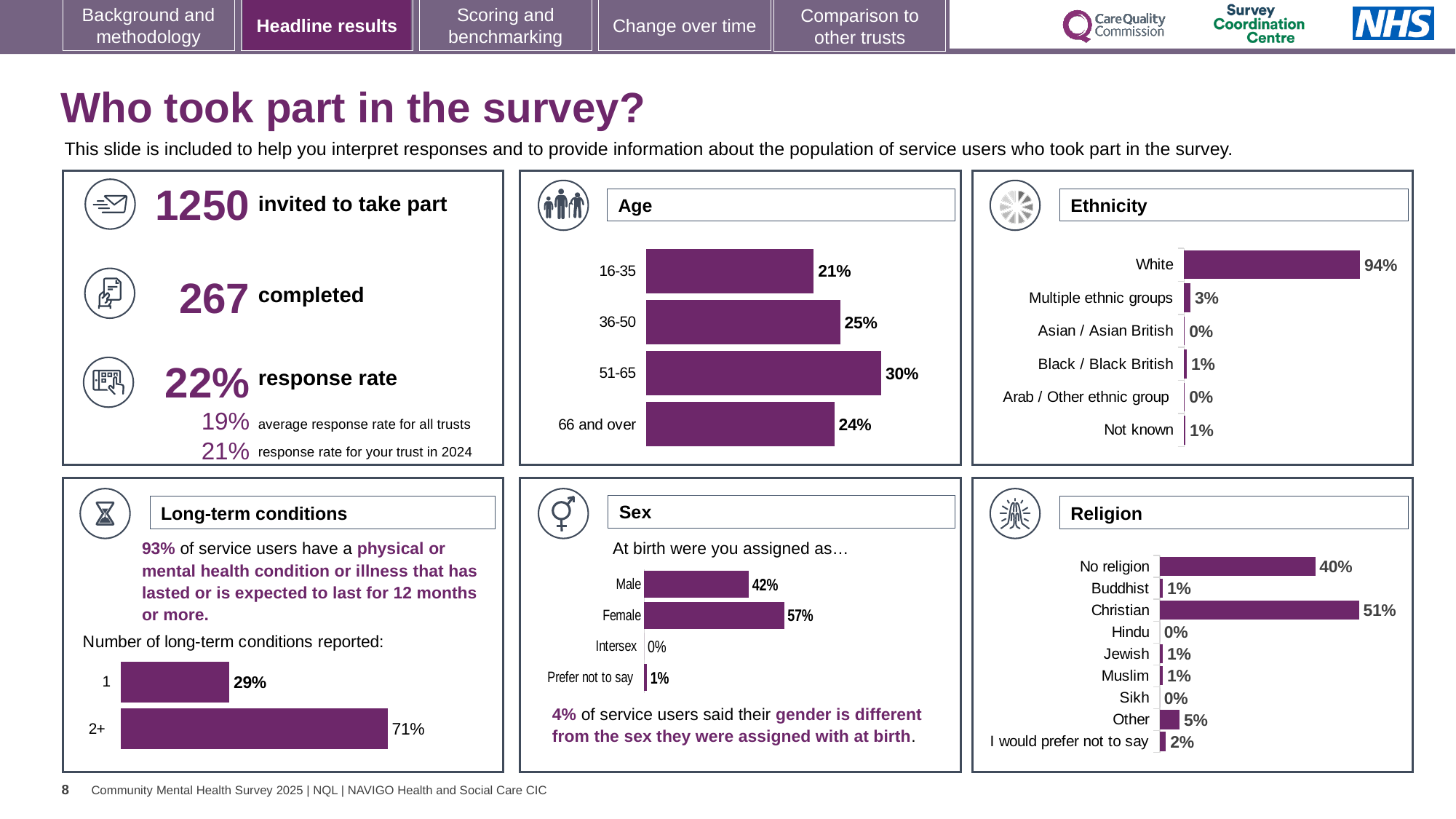
In the Age chart, what is the difference between the 36-50 and 66 and over groups? 1% What type of chart is used in the Age panel? Bar chart In the Ethnicity chart, what is the value for White? 94% In the Age chart, which age group has the lowest percentage? 16-35 In the Age chart, what percentage of respondents were aged 51-65? 30% In the Religion chart, what is the difference between Christian and No religion? 11% In the Religion chart, which category has the highest percentage? Christian In the Sex chart, which is larger, Male or Female? Female In the Ethnicity chart, how many ethnicity categories are shown? 6 In the Religion chart, what is the value for Other? 5% In the Sex chart, what is the difference between the Female and Male percentages? 15% In the Long-term conditions chart, what percentage of service users reported 2+ long-term conditions? 71%